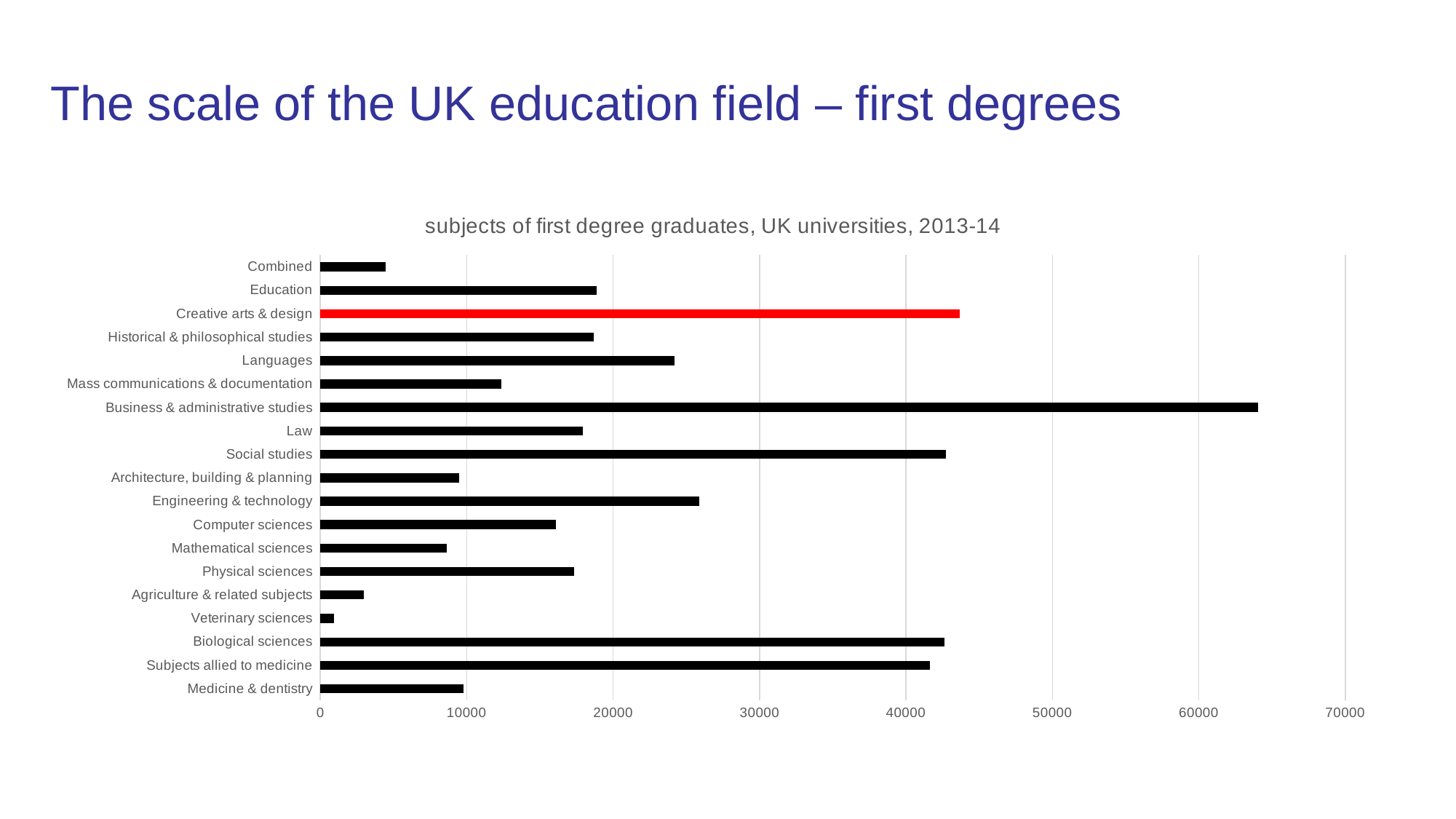
Which subject has the lowest number of first degree graduates? Veterinary sciences Which subject's bar is highlighted in red? Creative arts & design What kind of chart is shown on the slide? bar chart Is the value for Combined greater or less than 10000? less Which subject has the highest number of first degree graduates? Business & administrative studies Is the value for Social studies greater or less than 40000? greater Is the value for Business & administrative studies greater or less than 60000? greater Which has more first degree graduates, Creative arts & design or Education? Creative arts & design What is the title of the chart? subjects of first degree graduates, UK universities, 2013-14 Which has more first degree graduates, Engineering & technology or Computer sciences? Engineering & technology How many subject categories are shown in the chart? 19